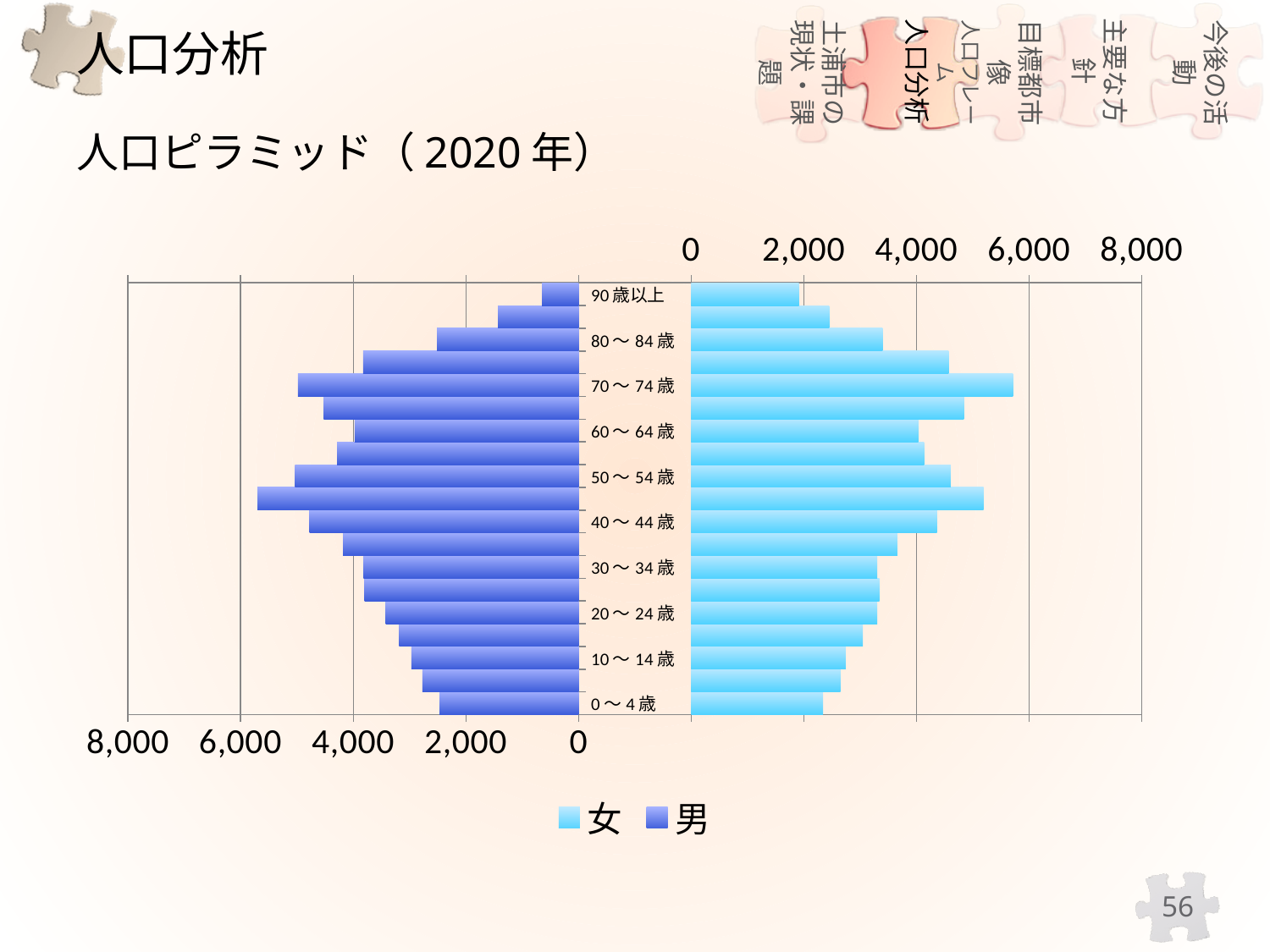
Which labeled age group has the highest 女 value? 70〜74歳 What are the two series named in the legend? 女 and 男 Is the 女 value for 80〜84歳 greater or less than 4,000? less Is the 男 value for 90歳以上 greater or less than 2,000? less Is the 女 value for 70〜74歳 greater or less than 4,000? greater How many age-group bars are plotted for the 男 series? 19 How many series does the legend list? 2 What is the title of the chart? 人口ピラミッド（2020年） What kind of chart is shown on the slide? bar chart For the 男 series, which is larger: the value for 70〜74歳 or the value for 0〜4歳? 70〜74歳